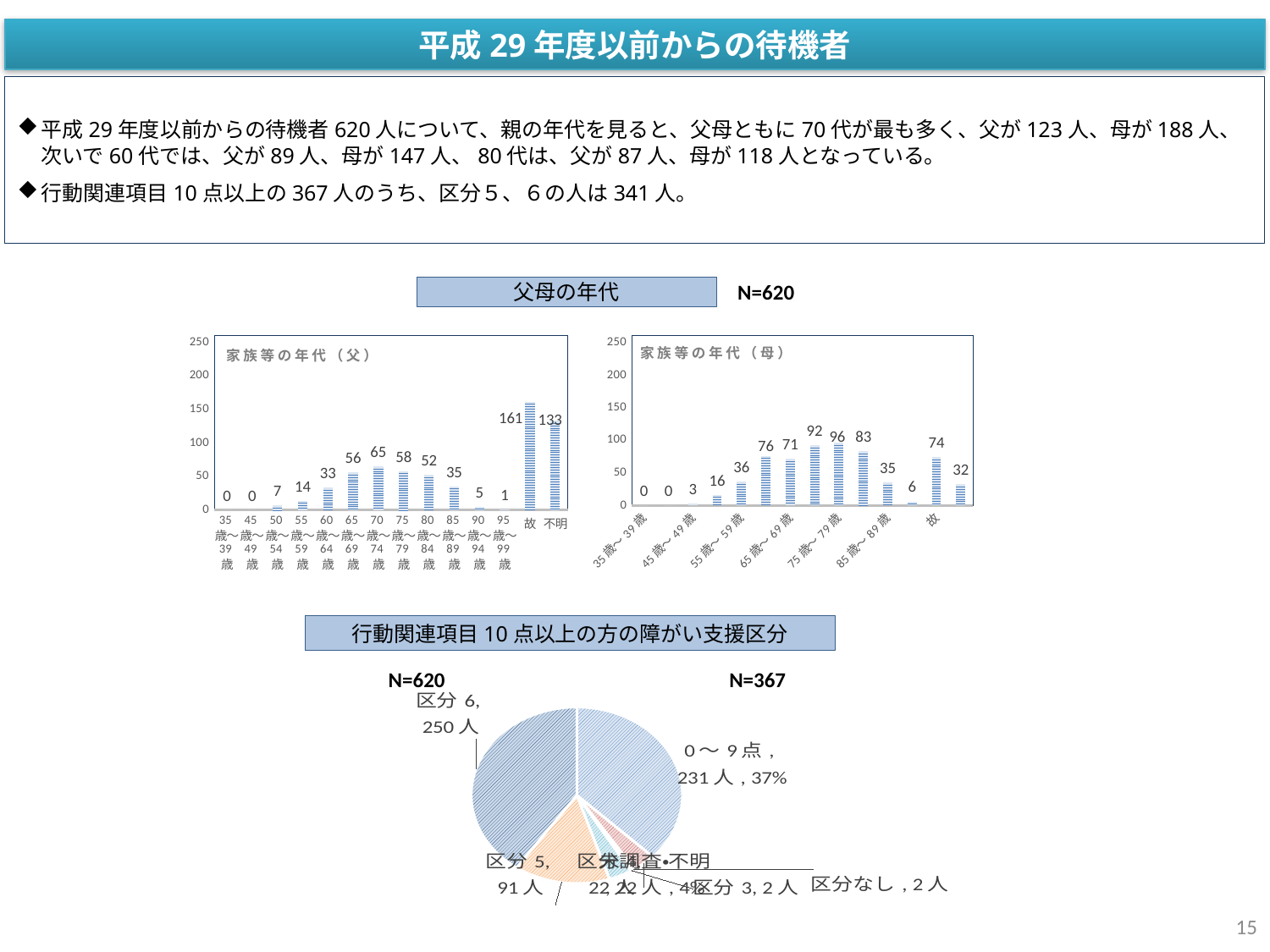
What kind of chart is the 家族等の年代（父） chart? bar chart In the 家族等の年代（父） chart, what is the value for 70歳〜74歳? 65 In the 家族等の年代（父） chart, what is the difference between the values for 故 and 不明? 28 In the 家族等の年代（母） chart, what is the value for 75歳〜79歳? 96 In the pie chart at the bottom of the slide, what share of the pie is the 0〜9点 slice? 37% In the pie chart at the bottom of the slide, how many people are in 区分5? 91人 In the 家族等の年代（父） chart, what is the value for 故? 161 How many categories are shown on the x axis of the 家族等の年代（父） chart? 14 In the 家族等の年代（母） chart, which is larger, the value for 65歳〜69歳 or the value for 75歳〜79歳? 75歳〜79歳 In the pie chart at the bottom of the slide, how many people are in 区分6? 250人 In the 家族等の年代（父） chart, which category has the highest value? 故 In the 家族等の年代（母） chart, what is the value for 故? 74